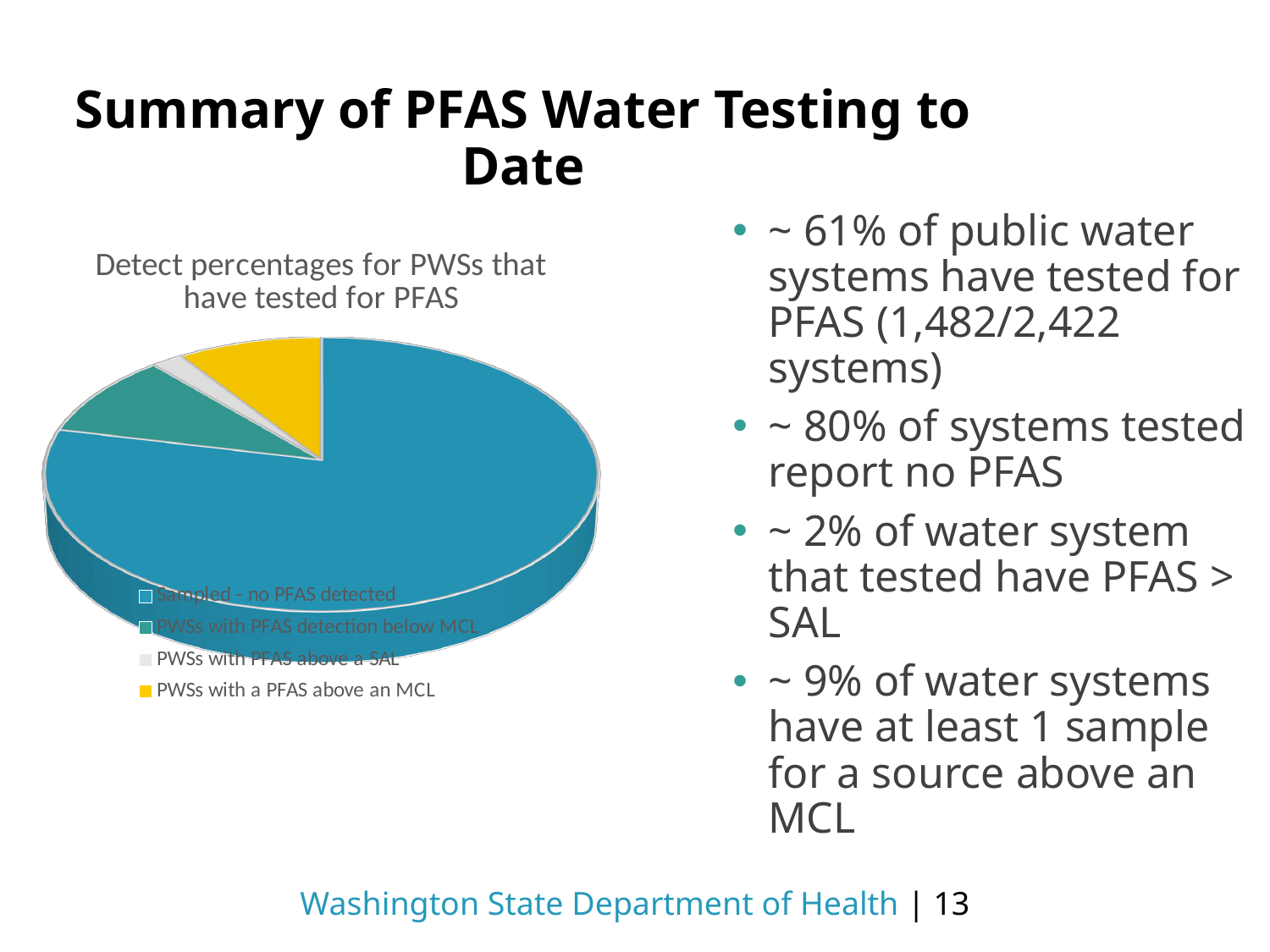
How many entries does the pie chart's legend list? 4 Which slice is larger: "Sampled - no PFAS detected" or "PWSs with a PFAS above an MCL"? Sampled - no PFAS detected What is the title of the pie chart? Detect percentages for PWSs that have tested for PFAS Which category has the largest slice of the pie chart? Sampled - no PFAS detected What kind of chart is shown on the slide? pie chart Which category has the smallest slice of the pie chart? PWSs with PFAS above a SAL Which legend entry is shown in yellow in the pie chart? PWSs with a PFAS above an MCL Which slice is larger: "PWSs with PFAS above a SAL" or "PWSs with a PFAS above an MCL"? PWSs with a PFAS above an MCL How many slices does the pie chart have? 4 Which slice is larger: "PWSs with PFAS detection below MCL" or "PWSs with PFAS above a SAL"? PWSs with PFAS detection below MCL